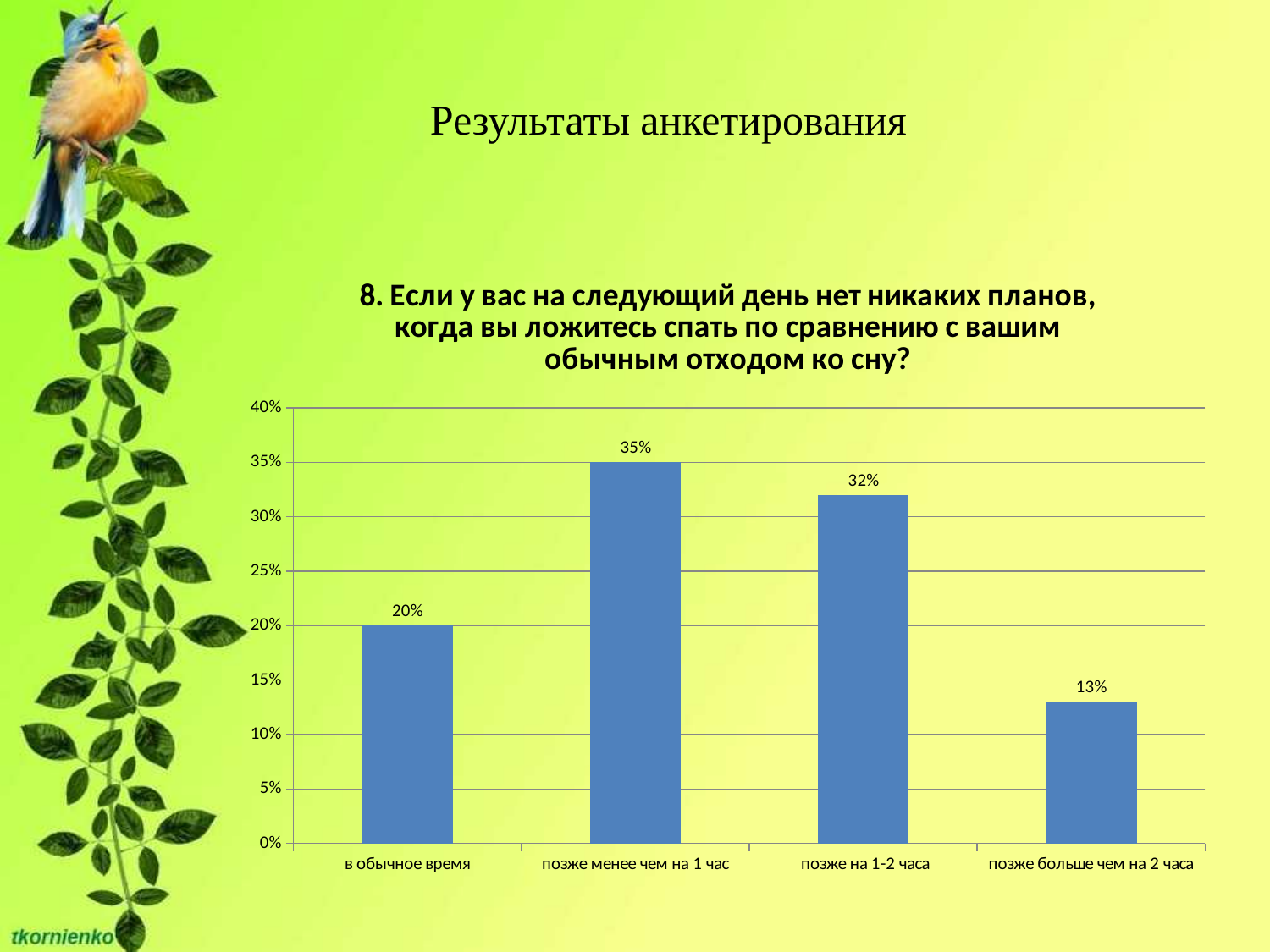
What is the difference between the values for "позже менее чем на 1 час" and "позже больше чем на 2 часа"? 22% Which is larger: the value for "в обычное время" or the value for "позже на 1-2 часа"? позже на 1-2 часа Is the value for "позже больше чем на 2 часа" greater or less than 15%? less What is the title of the chart? 8. Если у вас на следующий день нет никаких планов, когда вы ложитесь спать по сравнению с вашим обычным отходом ко сну? How many categories are shown on the x axis? 4 What is the value for "позже менее чем на 1 час"? 35% Which category has the highest value? позже менее чем на 1 час What is the value for "позже больше чем на 2 часа"? 13% What is the value for "в обычное время"? 20% What is the value for "позже на 1-2 часа"? 32% Which category has the lowest value? позже больше чем на 2 часа What kind of chart is shown on the slide? bar chart